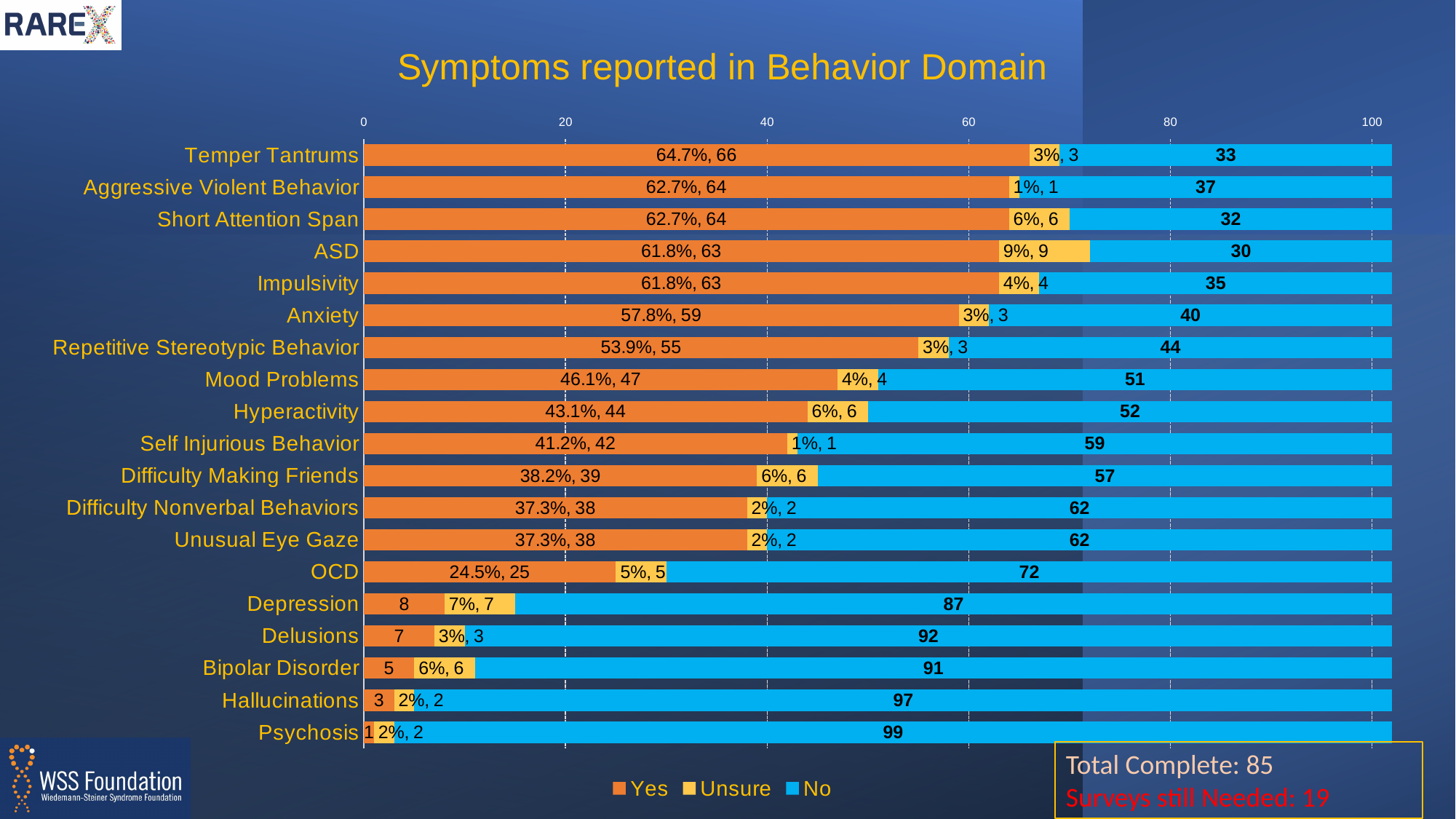
Which symptom has the highest Yes count? Temper Tantrums What kind of chart is shown? Stacked bar chart What is the data label on the Unsure segment for Hyperactivity? 6%, 6 What is the total of the Yes, Unsure and No counts for Temper Tantrums? 102 What is the No value for Psychosis? 99 Which symptom has the lowest Yes count? Psychosis How many series does the legend list? 3 Which has a larger Unsure count, ASD or Depression? ASD What is the difference between the No value for Depression and the No value for OCD? 15 What is the data label on the Yes segment for Temper Tantrums? 64.7%, 66 What is the title of the chart? Symptoms reported in Behavior Domain How many symptoms are listed on the chart? 19